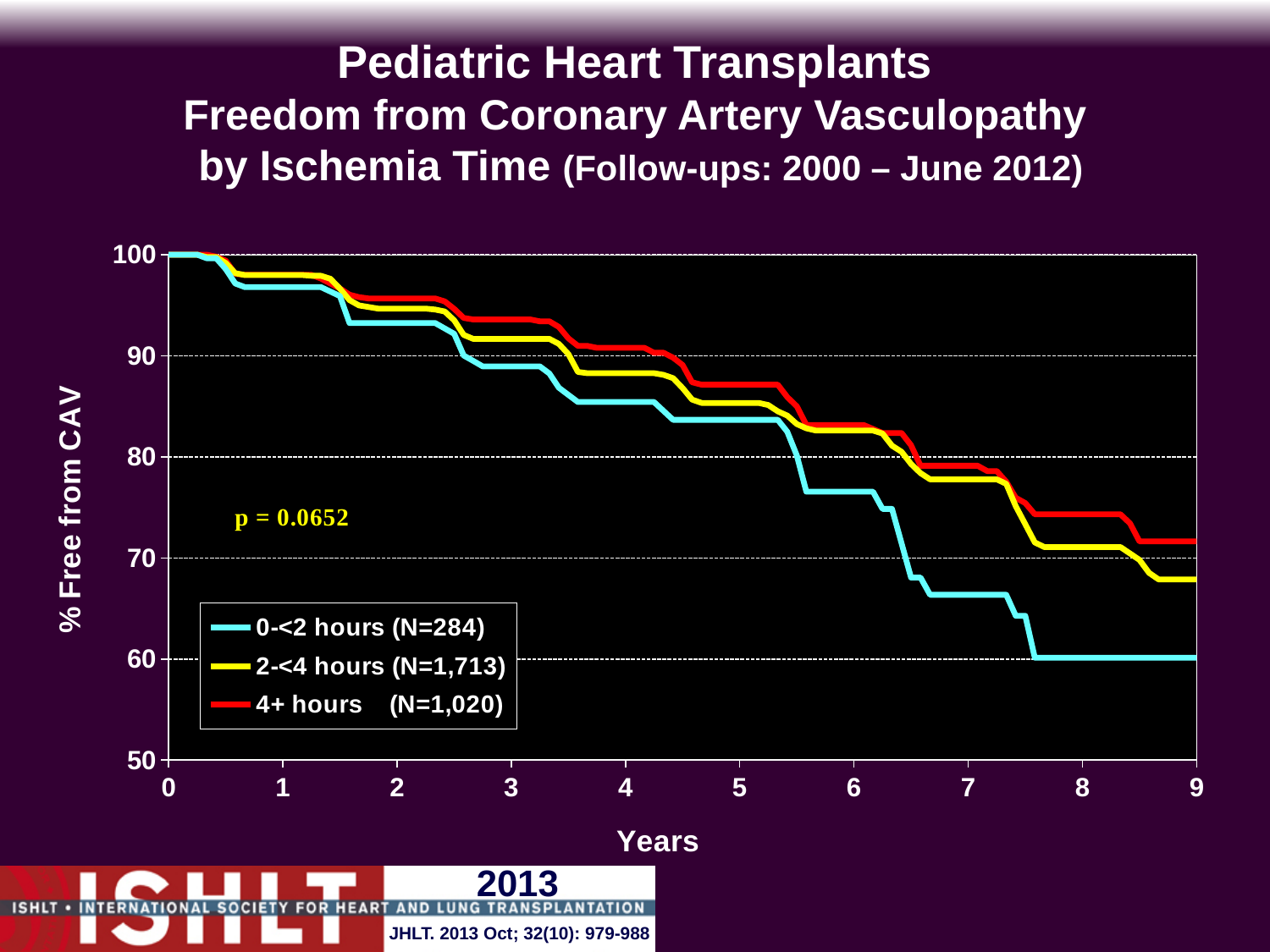
What is the N for the 0-<2 hours group shown in the legend? N=284 What is the N for the 2-<4 hours group shown in the legend? N=1,713 At 8 years, which group has the higher % Free from CAV, 4+ hours or 0-<2 hours? 4+ hours At 9 years, is the value for the 4+ hours group greater or less than 80? less At 2 years, is the value for the 4+ hours group greater or less than 90? greater What kind of chart is shown on the slide? line chart What is the N for the 4+ hours group shown in the legend? N=1,020 Do the % Free from CAV values rise or fall as years increase? fall What p-value is printed on the chart? p = 0.0652 At 9 years, which group has the lowest % Free from CAV? 0-<2 hours How many series does the legend list? 3 At 8 years, is the value for the 0-<2 hours group greater or less than 70? less